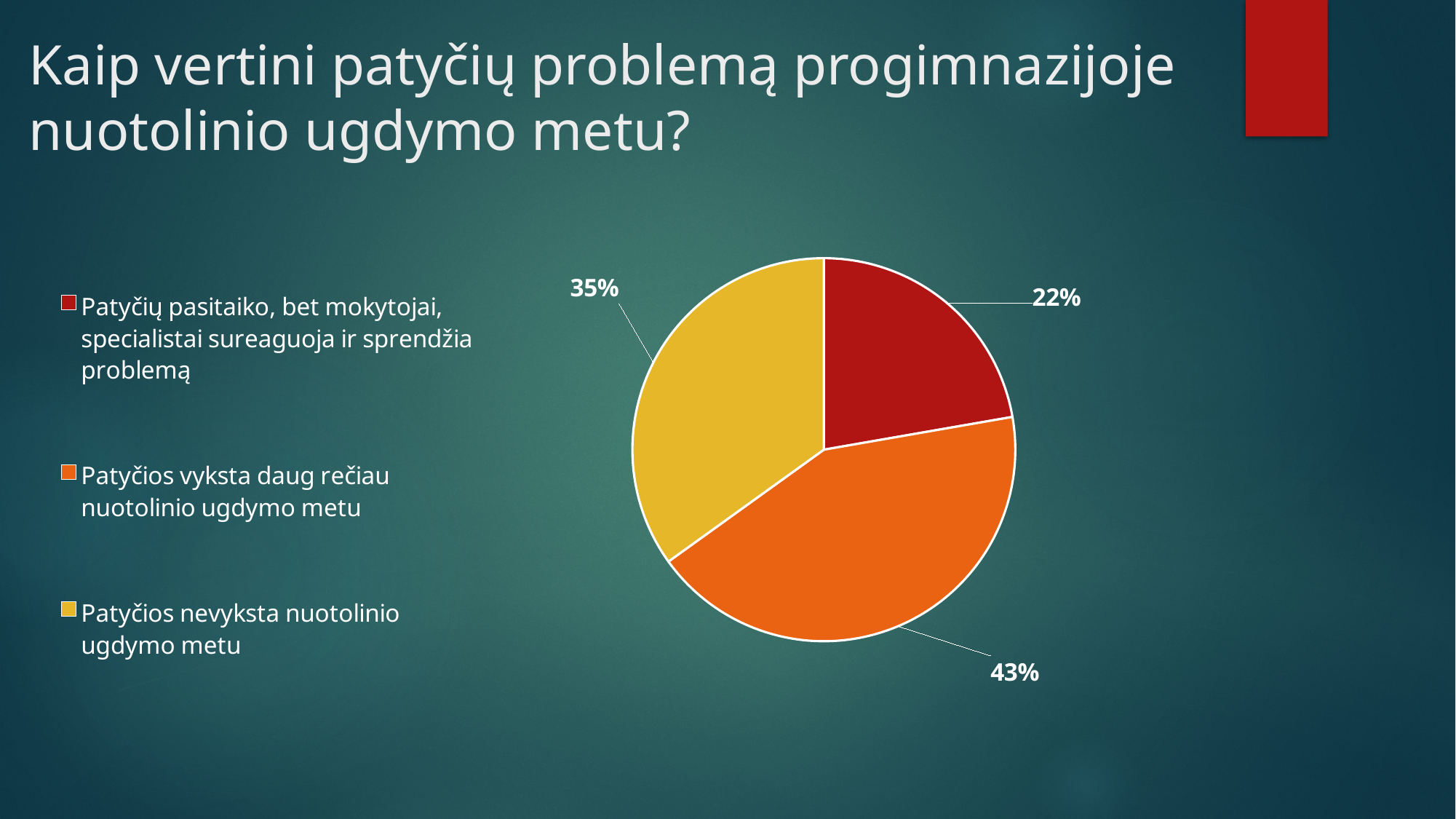
What is the difference in percentage points between the largest and smallest slices? 21 Which category has the largest slice of the pie? Patyčios vyksta daug rečiau nuotolinio ugdymo metu What colour is the slice for "Patyčios nevyksta nuotolinio ugdymo metu"? yellow What share of the pie is labelled "Patyčios nevyksta nuotolinio ugdymo metu"? 35% How many slices does the pie chart have? 3 What is the difference in percentage points between "Patyčios vyksta daug rečiau nuotolinio ugdymo metu" and "Patyčios nevyksta nuotolinio ugdymo metu"? 8 Which category has the smallest slice of the pie? Patyčių pasitaiko, bet mokytojai, specialistai sureaguoja ir sprendžia problemą What share of the pie is labelled "Patyčios vyksta daug rečiau nuotolinio ugdymo metu"? 43% Which is larger: the slice for "Patyčios nevyksta nuotolinio ugdymo metu" or the slice for "Patyčių pasitaiko, bet mokytojai, specialistai sureaguoja ir sprendžia problemą"? Patyčios nevyksta nuotolinio ugdymo metu What is the title of the slide containing the pie chart? Kaip vertini patyčių problemą progimnazijoje nuotolinio ugdymo metu? What kind of chart is shown on the slide? pie chart What share of the pie is labelled "Patyčių pasitaiko, bet mokytojai, specialistai sureaguoja ir sprendžia problemą"? 22%